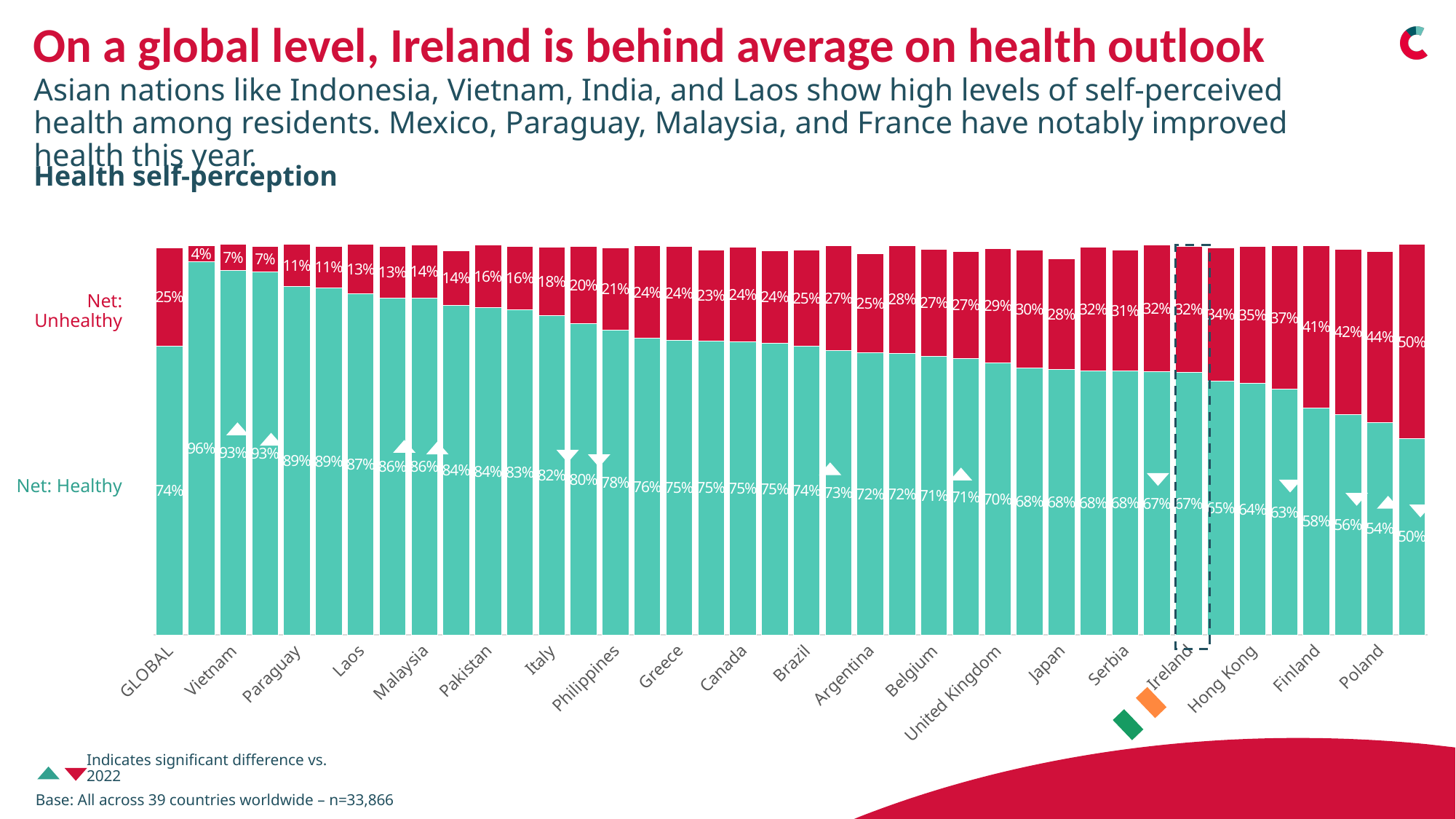
What is the Net: Healthy value for Poland? 54% What is the Net: Unhealthy value for Ireland? 32% What is the title of the chart? Health self-perception What is the Net: Unhealthy value for Finland? 41% What is the Net: Healthy value for GLOBAL? 74% What is the Net: Healthy value for Ireland? 67% By how many percentage points is the GLOBAL Net: Healthy value higher than Ireland's? 7 percentage points Do the Net: Healthy values rise or fall moving from left to right across the chart? Fall Which has the higher Net: Healthy value, Ireland or GLOBAL? GLOBAL What kind of chart is shown on the slide? Stacked bar chart What is the Net: Healthy value for Hong Kong? 64% What is the Net: Unhealthy value for GLOBAL? 25%